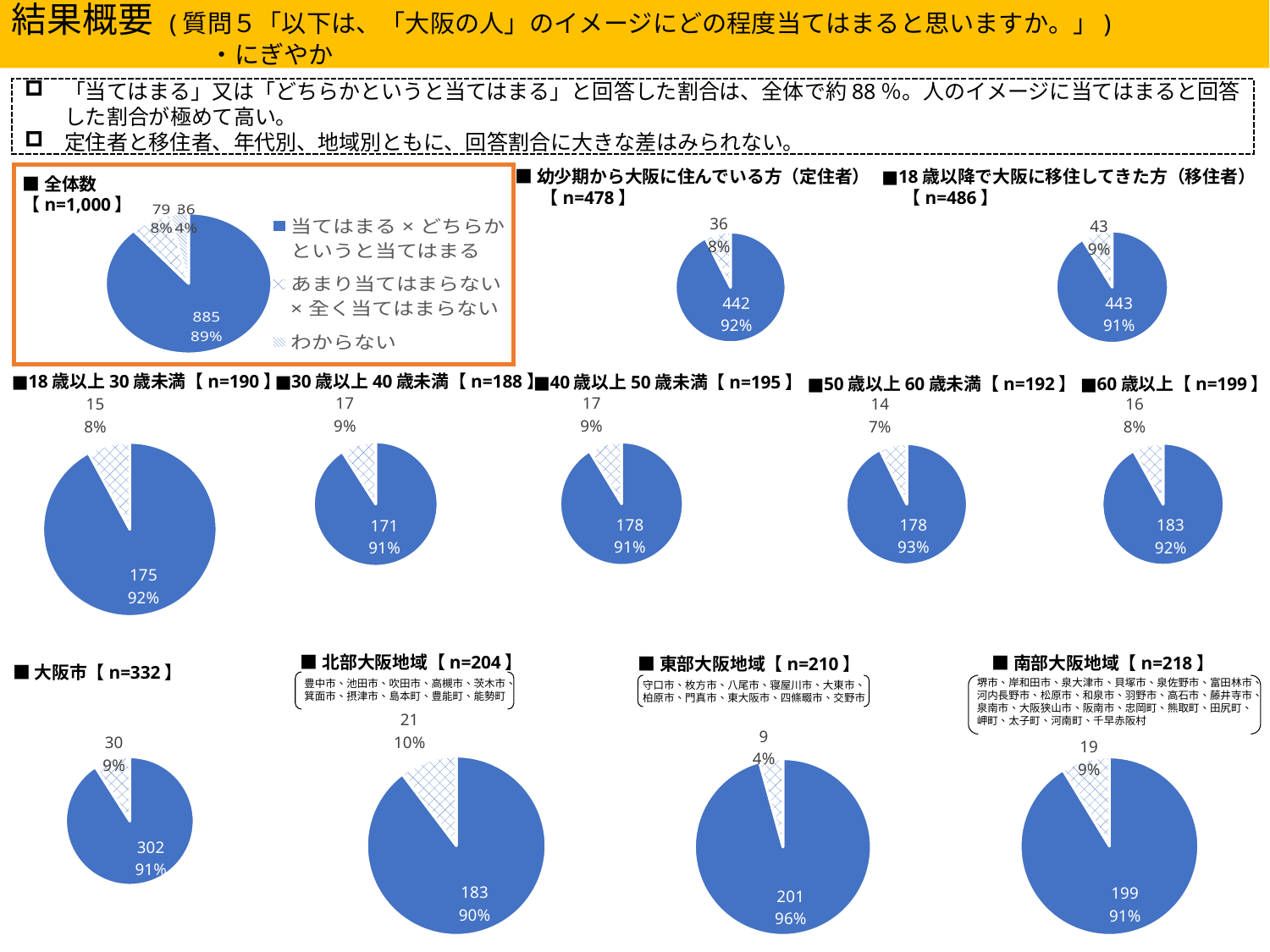
In the 18歳以降で大阪に移住してきた方（移住者） (n=486) pie chart, what percentage is shown for the smaller slice? 9% How many series does the legend of the 全体数 (n=1,000) pie chart list? 3 In the 全体数 (n=1,000) pie chart, what share of the pie is わからない? 4% What kind of chart is used on this slide for the 全体数 (n=1,000) data? pie chart What is the difference between the larger slice values in the 大阪市 (n=332) pie chart (302) and the 北部大阪地域 (n=204) pie chart (183)? 119 In the 50歳以上60歳未満 (n=192) pie chart, what percentage is shown for the larger slice? 93% In the 60歳以上 (n=199) pie chart, what is the value of the larger slice? 183 In the 東部大阪地域 (n=210) pie chart, what is the value of the smaller slice? 9 Which pie chart shows a larger percentage for the main slice: 東部大阪地域 (n=210) or 北部大阪地域 (n=204)? 東部大阪地域 In the 全体数 (n=1,000) pie chart, which category is the smallest? わからない In the 幼少期から大阪に住んでいる方（定住者） (n=478) pie chart, what is the value of the larger slice? 442 In the 全体数 (n=1,000) pie chart, what is the value for 当てはまる×どちらかというと当てはまる? 885